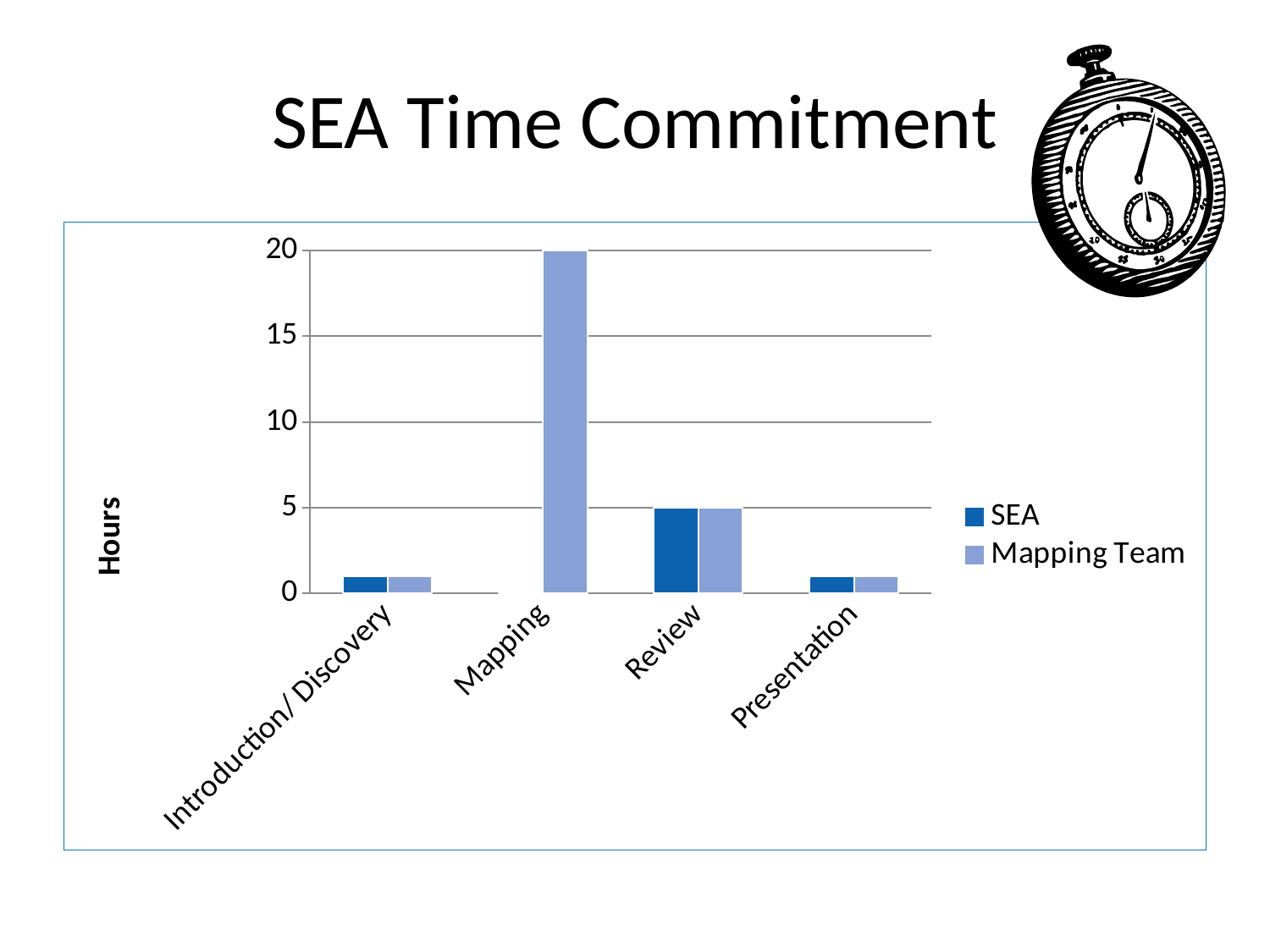
How many series does the legend list? 2 What kind of chart is shown on the slide? bar chart What is the Mapping Team value for Review? 5 What is the Mapping Team value for Mapping? 20 Is the Mapping Team value for Presentation greater or less than 5? less What is the label on the vertical axis? Hours Is the SEA value for Introduction/ Discovery greater or less than 5? less Which is larger for the Mapping Team series: Mapping or Review? Mapping How many categories are shown on the x axis? 4 What is the difference between the Mapping Team values for Mapping and Review? 15 Which category has the highest Mapping Team value? Mapping What is the SEA value for Review? 5